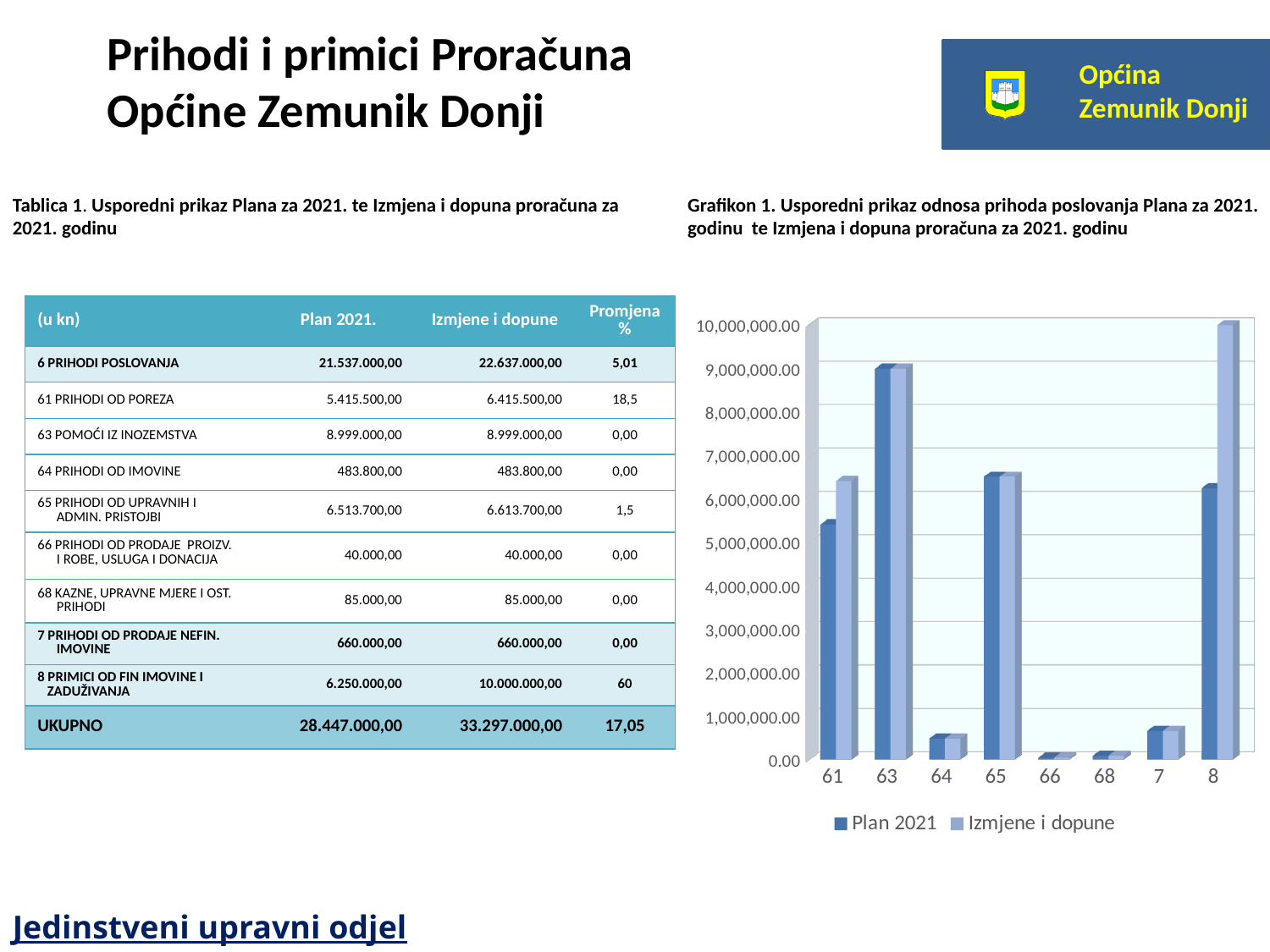
Which category has the highest Plan 2021 bar in the chart? 63 How many series does the chart legend list? 2 In the chart, which Plan 2021 bar is taller: category 63 or category 65? 63 What kind of chart is Grafikon 1 on the slide? bar chart What are the two series named in the chart legend? Plan 2021 and Izmjene i dopune In the chart, is the Plan 2021 value for category 64 greater or less than 1,000,000.00? less In the chart, for category 8, which series has the larger bar: Plan 2021 or Izmjene i dopune? Izmjene i dopune In the chart, is the Plan 2021 value for category 8 greater or less than 7,000,000.00? less How many categories are shown on the x axis of the chart? 8 In the chart, is the Plan 2021 value for category 61 greater or less than 5,000,000.00? greater Which category has the highest Izmjene i dopune bar in the chart? 8